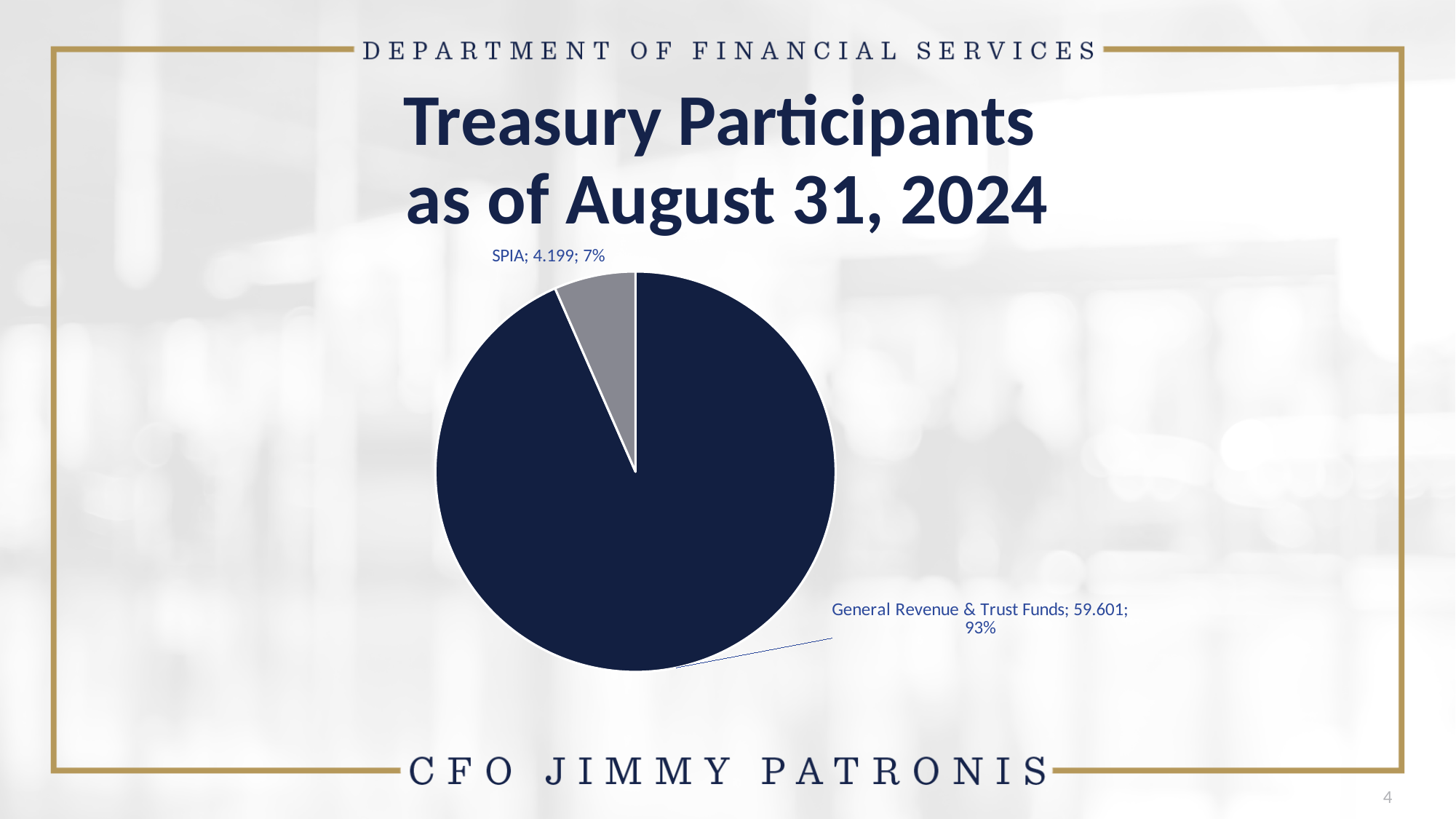
What is the title of the slide containing the chart? Treasury Participants as of August 31, 2024 How many slices does the pie chart have? 2 What is the difference between the values for General Revenue & Trust Funds and SPIA? 55.402 Which slice is the smallest? SPIA What share of the pie does General Revenue & Trust Funds represent? 93% What is the value shown for SPIA? 4.199 What colour is the SPIA slice? grey Which is larger, the value for SPIA or the value for General Revenue & Trust Funds? General Revenue & Trust Funds Which slice is the largest? General Revenue & Trust Funds What is the value shown for General Revenue & Trust Funds? 59.601 What share of the pie does SPIA represent? 7% What kind of chart is shown on the slide? pie chart